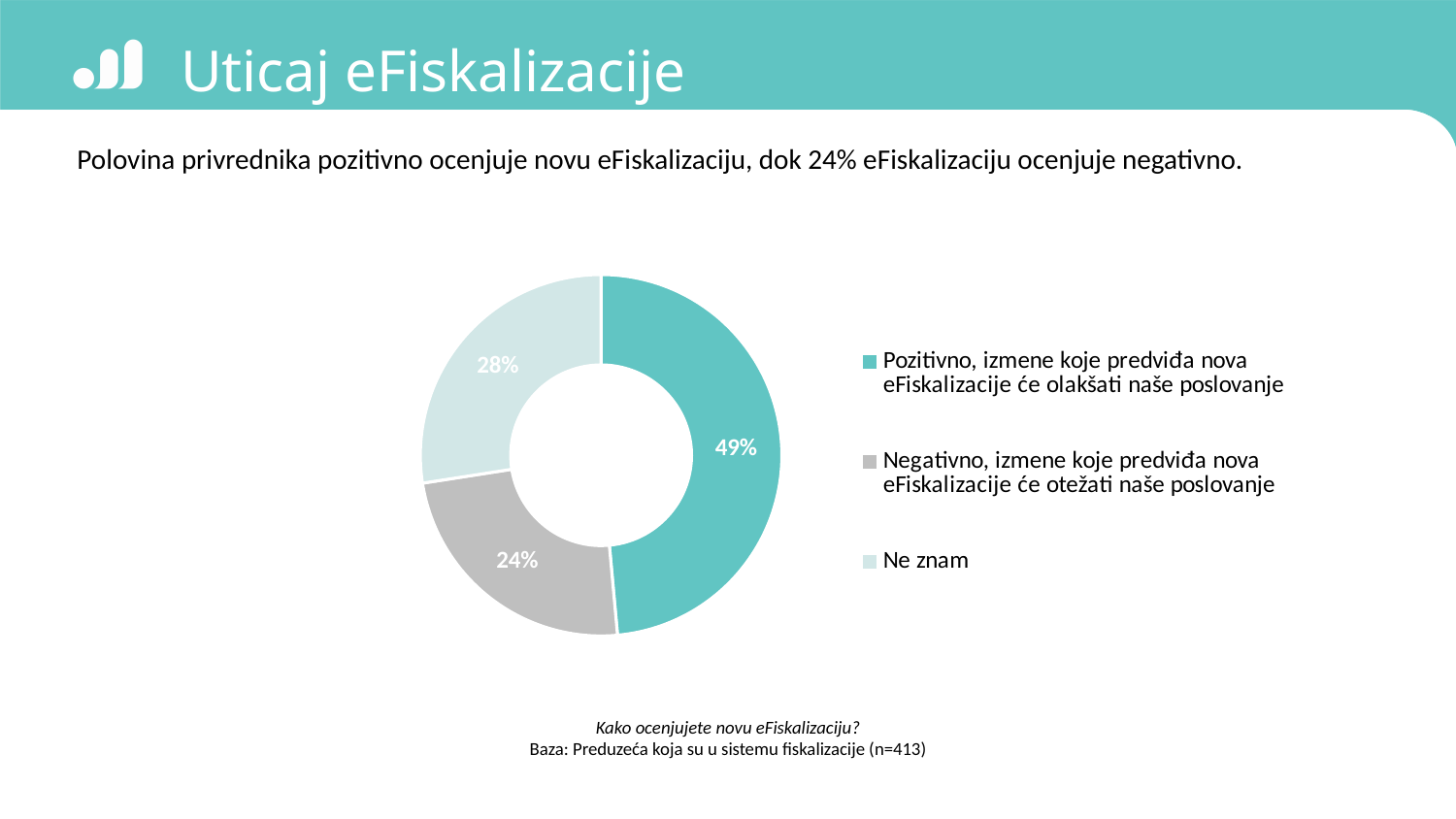
Which is larger: the "Ne znam" share or the "Negativno" share? Ne znam What kind of chart is shown on the slide? Pie chart (doughnut) Which response has the largest share of the pie? Pozitivno, izmene koje predviđa nova eFiskalizacije će olakšati naše poslovanje What share of respondents answered "Pozitivno, izmene koje predviđa nova eFiskalizacije će olakšati naše poslovanje"? 49% What is the difference in percentage points between the "Pozitivno" and "Negativno" shares? 25 What share of respondents answered "Negativno, izmene koje predviđa nova eFiskalizacije će otežati naše poslovanje"? 24% What is the sample size (n) stated in the base note below the chart? 413 What is the combined share of the "Pozitivno" and "Ne znam" responses? 77% Which response has the smallest share of the pie? Negativno, izmene koje predviđa nova eFiskalizacije će otežati naše poslovanje How many categories does the pie chart show? 3 What share of respondents answered "Ne znam"? 28% What survey question is shown below the chart? Kako ocenjujete novu eFiskalizaciju?